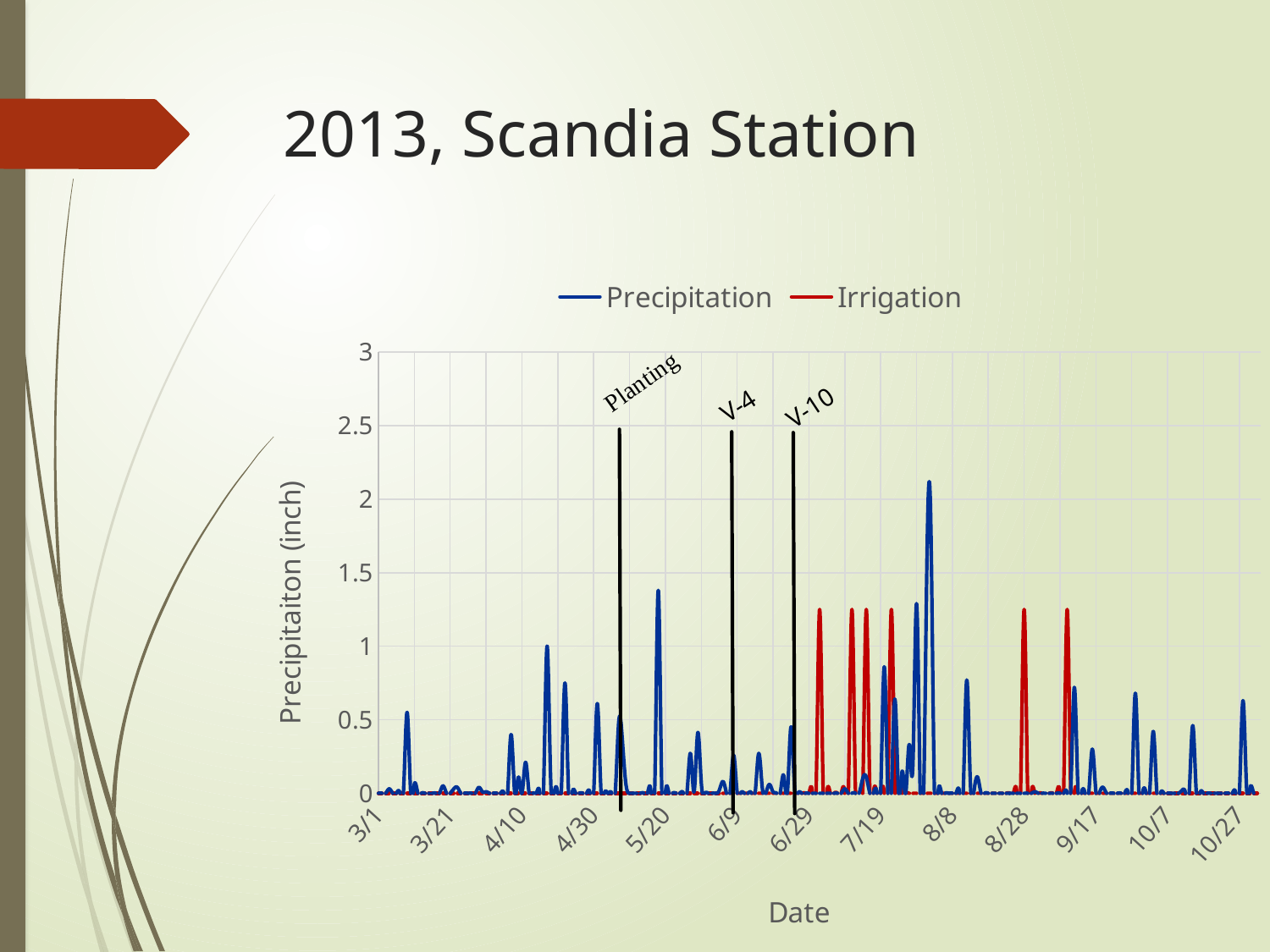
Is the highest Irrigation peak greater or less than 1? greater What are the two series named in the legend? Precipitation and Irrigation Is the highest Precipitation peak greater or less than 2? greater How many date labels are shown on the x axis? 13 Which series reaches the highest value on the chart, Precipitation or Irrigation? Precipitation Is the Precipitation peak just before 5/20 greater or less than 1? greater How many series does the legend list? 2 How many Irrigation events (red peaks) are plotted on the chart? 6 What is the title of the slide containing the chart? 2013, Scandia Station What is the maximum value shown on the y axis? 3 What type of chart is shown on the slide? line chart